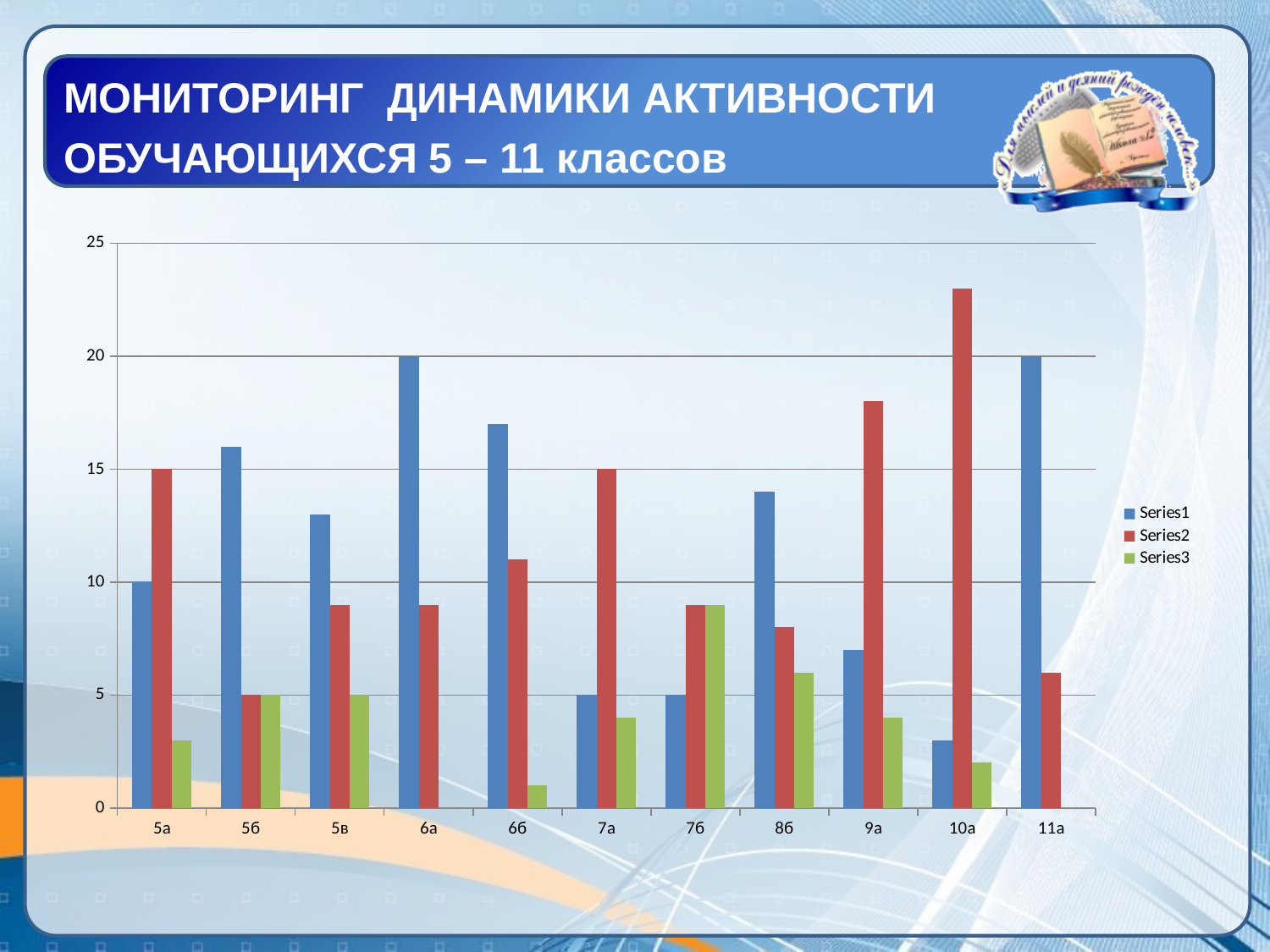
How many categories are shown on the x axis? 11 How many series does the legend list? 3 What is the value of Series2 for 7а? 15 What is the difference between Series2 and Series1 for 5а? 5 Which category has the lowest Series1 value? 10а What is the value of Series1 for 5а? 10 For 10а, which is larger: Series1 or Series2? Series2 Which category has the highest Series2 value? 10а Is the value of Series2 for 9а greater or less than 15? greater What kind of chart is shown on the slide? bar chart What is the value of Series1 for 6а? 20 What is the value of Series2 for 5а? 15